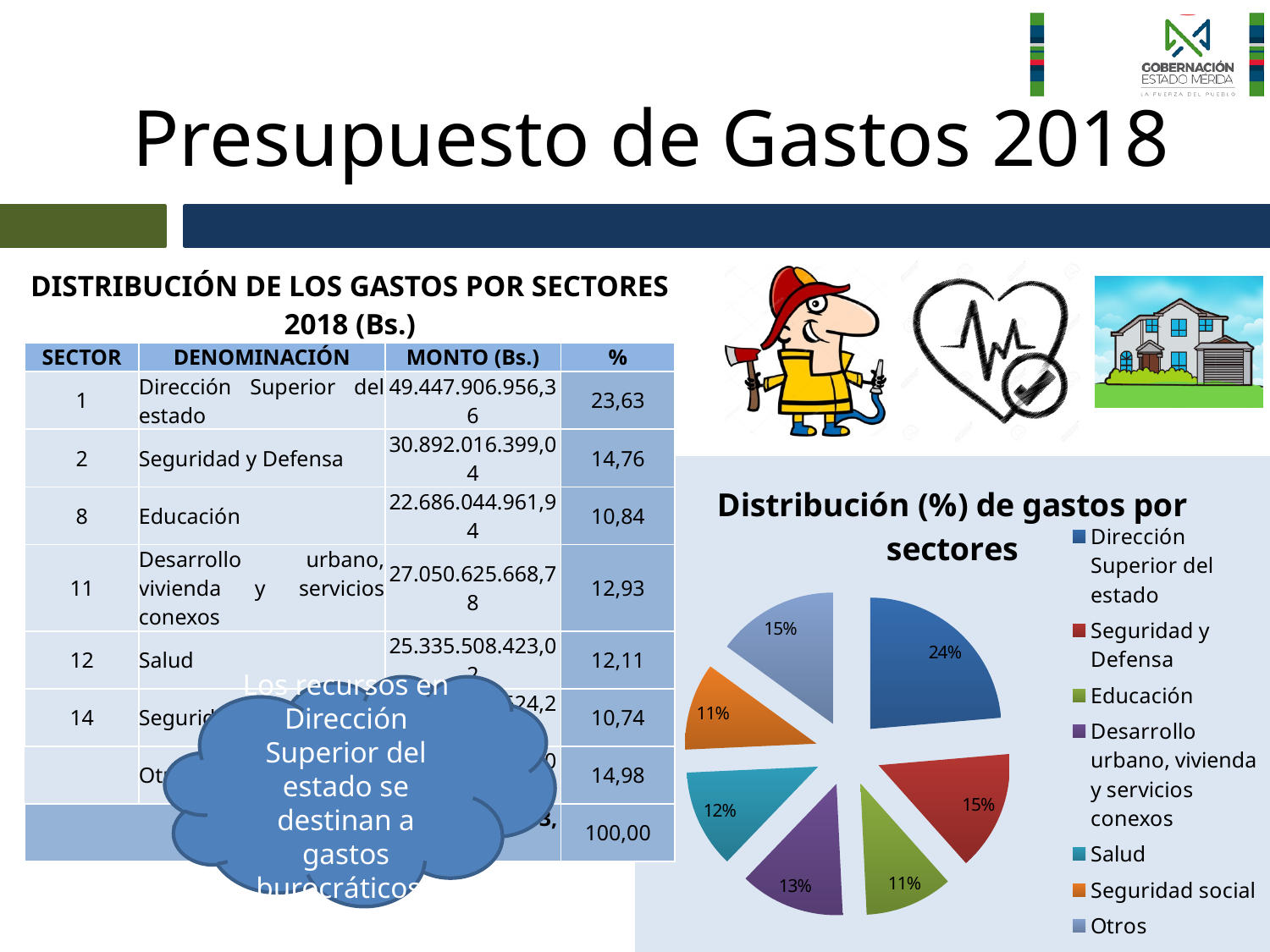
Which sector has the largest share of the pie? Dirección Superior del estado What percentage of the pie does Salud represent? 12% What is the title of the chart? Distribución (%) de gastos por sectores What percentage of the pie does Educación represent? 11% Which has a larger share, Desarrollo urbano, vivienda y servicios conexos or Seguridad social? Desarrollo urbano, vivienda y servicios conexos What percentage of the pie does Seguridad y Defensa represent? 15% What type of chart is shown on the slide? pie chart What percentage of the pie does Otros represent? 15% What percentage of the pie does Dirección Superior del estado represent? 24% What percentage of the pie does Desarrollo urbano, vivienda y servicios conexos represent? 13% How many slices does the pie chart have? 7 What is the difference in percentage points between Dirección Superior del estado and Salud? 12